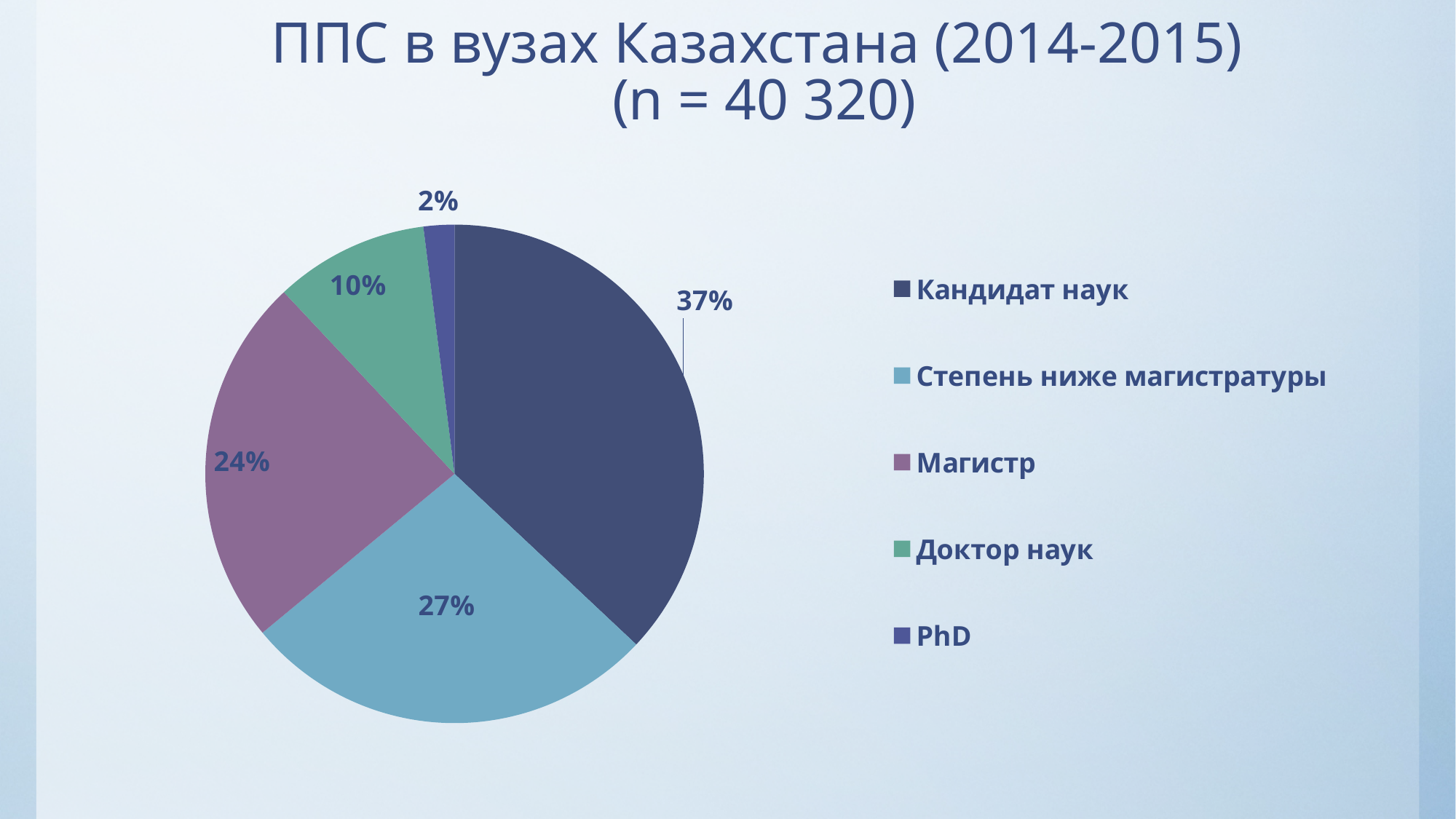
What share of the pie does Степень ниже магистратуры have? 27% What kind of chart is shown on the slide? pie chart What share of the pie does Доктор наук have? 10% How many categories does the legend list? 5 What share of the pie does PhD have? 2% What is the title of the chart? ППС в вузах Казахстана (2014-2015) (n = 40 320) What is the difference in percentage points between Кандидат наук and Магистр? 13 Which category has the largest slice of the pie? Кандидат наук Which category has the smallest slice of the pie? PhD Which is larger, the slice for Степень ниже магистратуры or the slice for Доктор наук? Степень ниже магистратуры